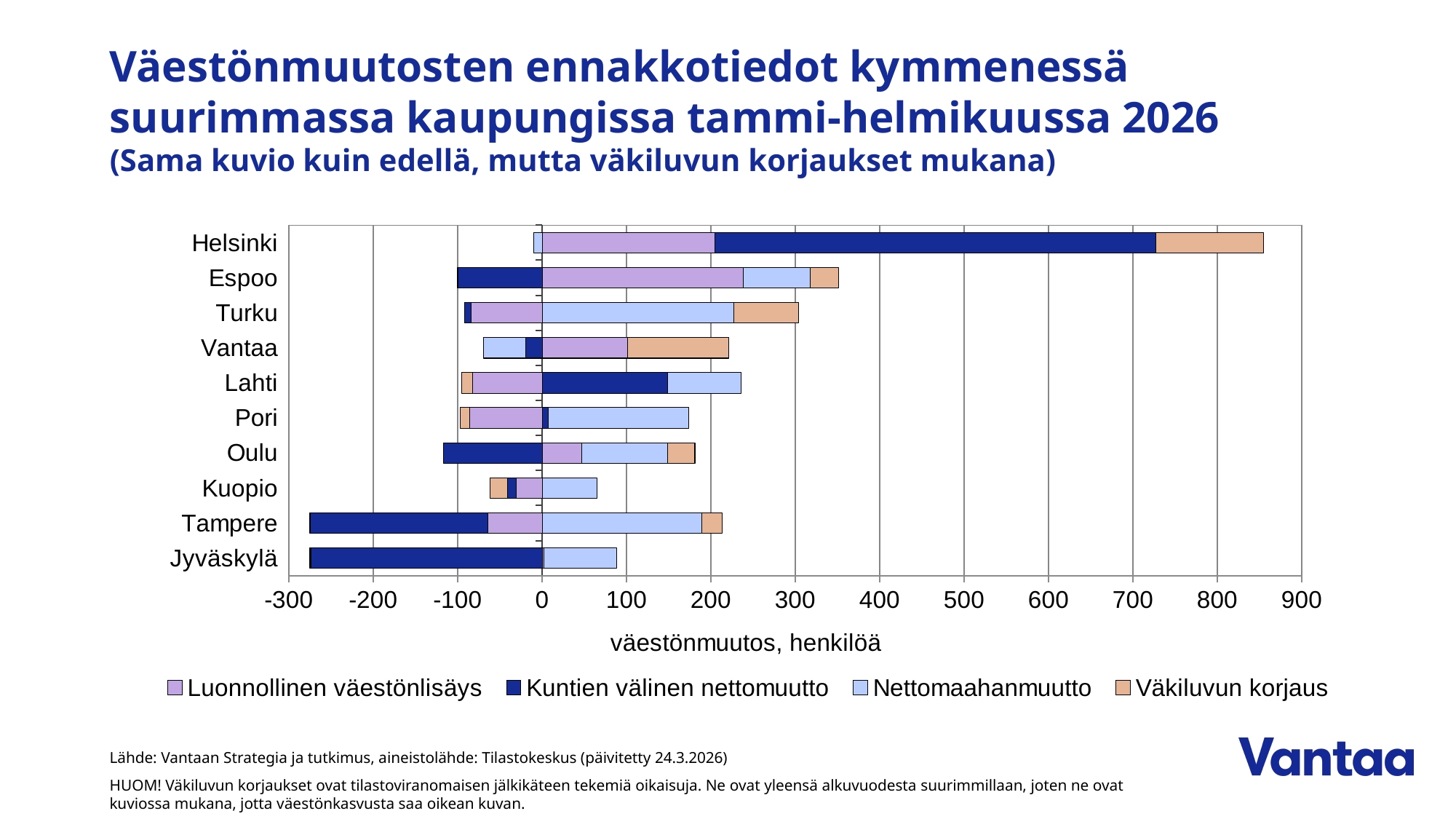
What is the title of the horizontal axis of the chart? väestönmuutos, henkilöä Is the Kuntien välinen nettomuutto value for Oulu greater or less than -100? less Which city has the most negative Kuntien välinen nettomuutto value? Jyväskylä What kind of chart is shown on the slide? Stacked bar chart Which series is shown in the darkest blue colour in the legend? Kuntien välinen nettomuutto Which is larger, the Nettomaahanmuutto value for Turku or for Kuopio? Turku Is the Kuntien välinen nettomuutto value for Helsinki greater or less than 400? greater Which city has the longest positive stacked bar in the chart? Helsinki Is the Luonnollinen väestönlisäys value for Espoo greater or less than 200? greater How many cities are listed on the vertical axis of the chart? 10 How many series does the chart's legend list? 4